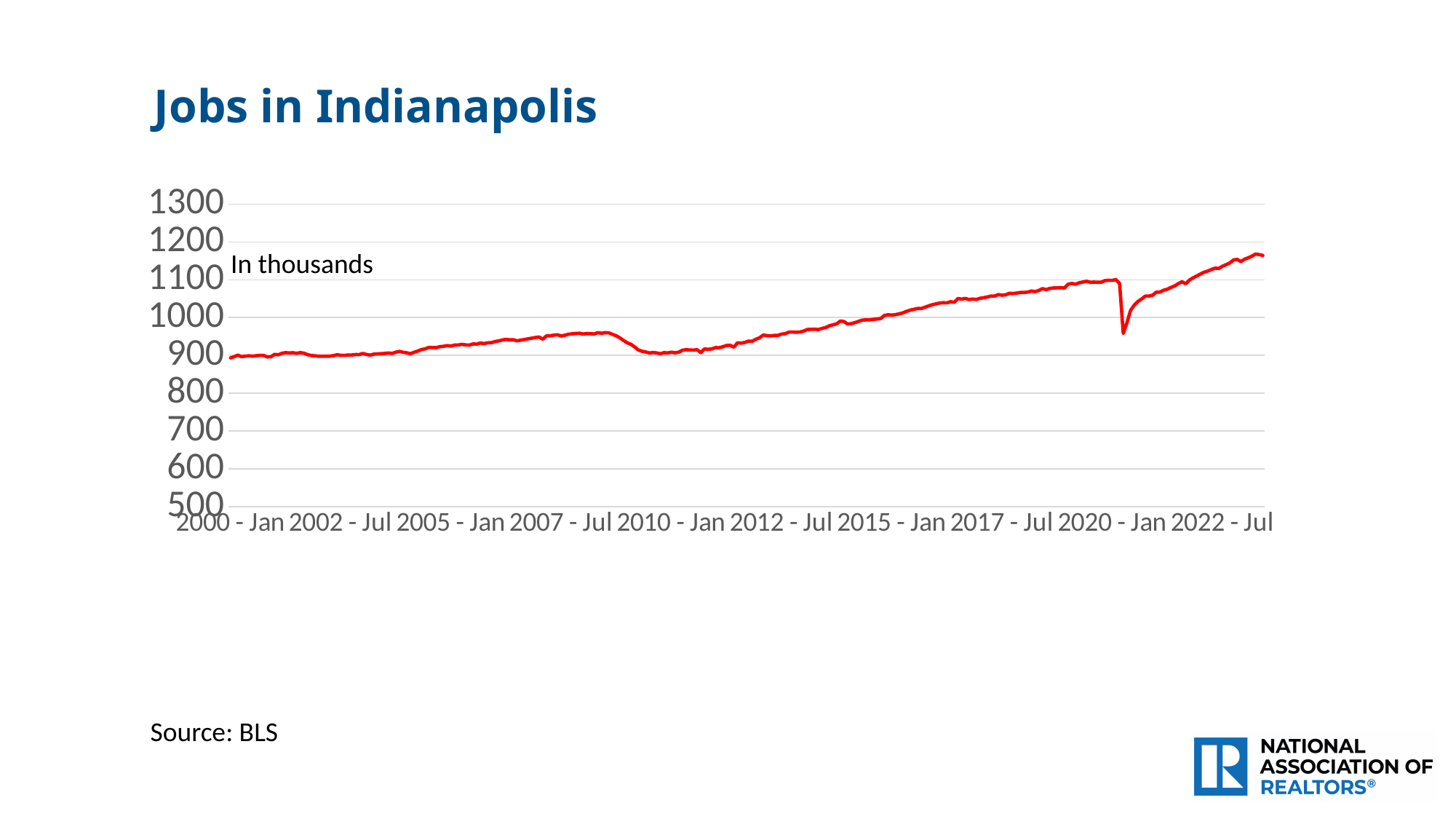
How many date labels are shown on the x axis? 10 Is the value for 2017 - Jul greater or less than 1000? greater How many lines are plotted on the chart? 1 What is the title of the chart? Jobs in Indianapolis Is the value for 2010 - Jan greater or less than 1000? less Is the value for 2020 - Jan greater or less than 1000? greater Which is larger, the value for 2022 - Jul or the value for 2000 - Jan? 2022 - Jul What kind of chart is shown on the slide? line chart In what units are the values on the chart expressed? In thousands Overall, do the values rise or fall from 2000 - Jan to 2022 - Jul? rise